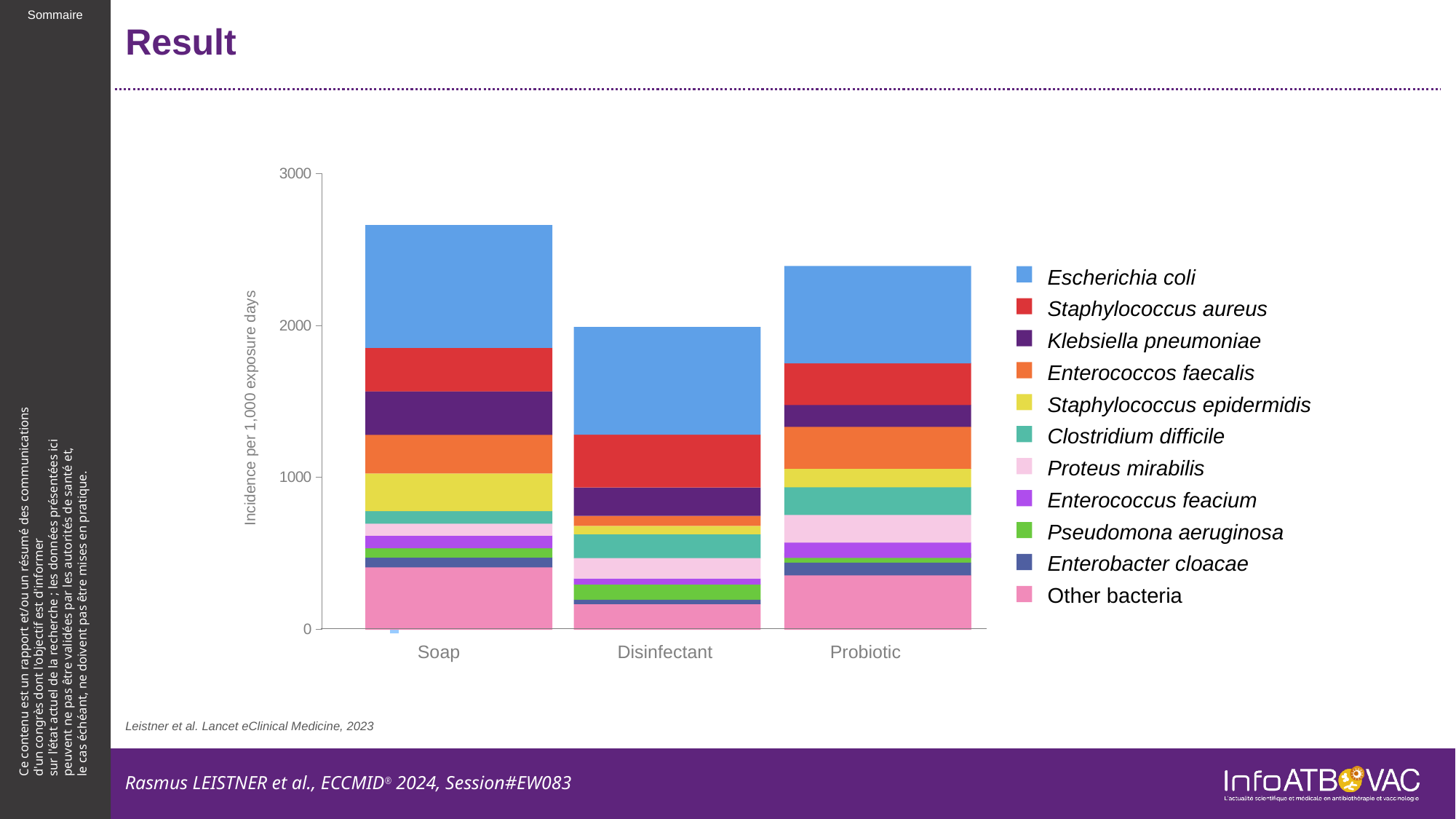
Is the total value for Probiotic greater or less than 2000? greater Which category has the lowest total incidence? Disinfectant What kind of chart is shown on the slide? Stacked bar chart How many categories are shown on the x axis of the chart? 3 What is the title of the y axis? Incidence per 1,000 exposure days How many series does the chart's legend list? 11 Which has the larger total incidence, Soap or Probiotic? Soap Is the total value for Soap greater or less than 3000? less Which category has the smallest 'Other bacteria' segment? Disinfectant Which category has the highest total incidence? Soap Is the total value for Soap greater or less than 2000? greater Which series is listed first in the legend? Escherichia coli